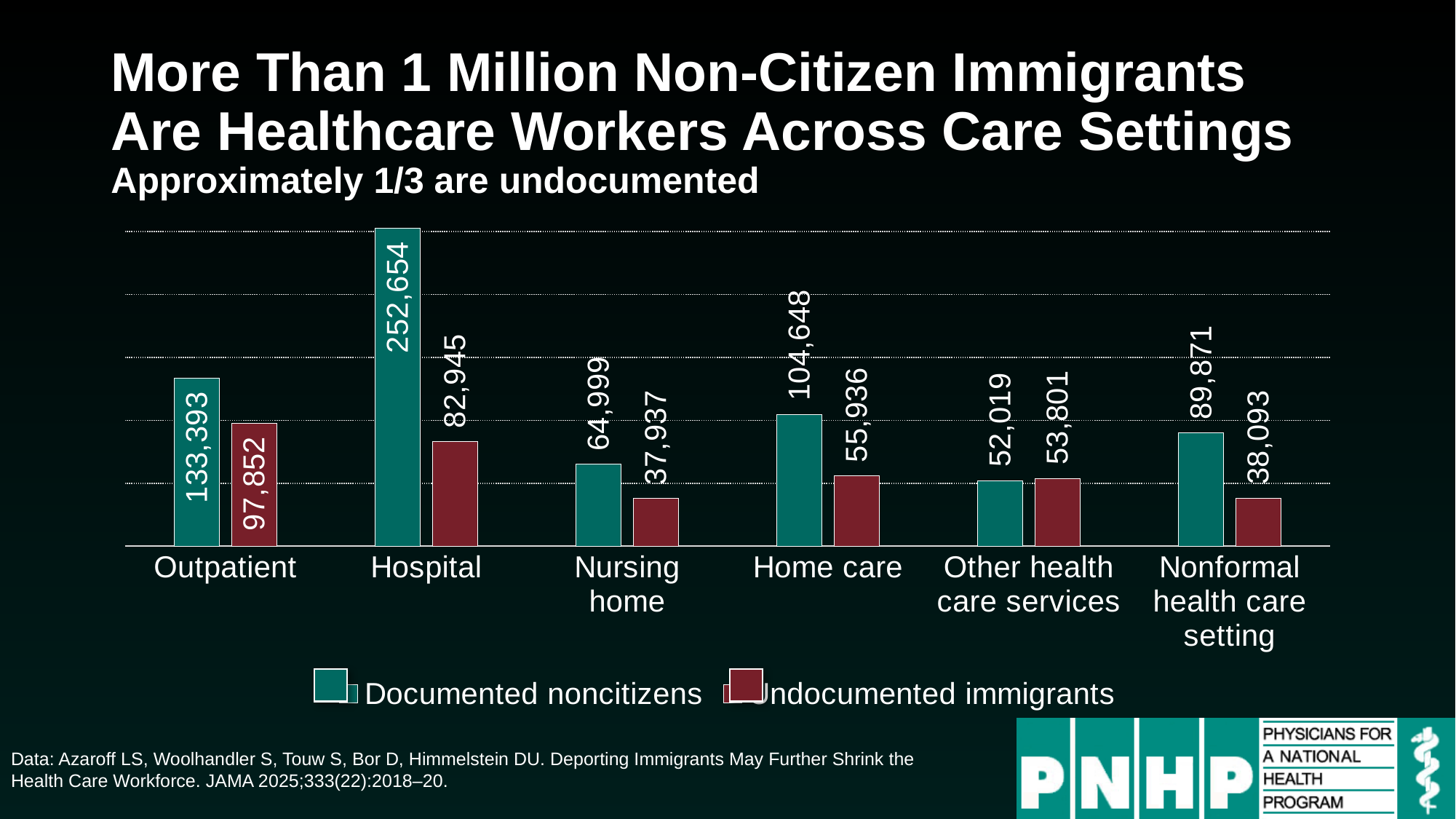
What is the value for Documented noncitizens in the Hospital category? 252,654 Which category has the lowest value for Undocumented immigrants? Nursing home How many categories are shown on the x axis? 6 What colour are the bars for Undocumented immigrants? Dark red Which category has the highest value for Documented noncitizens? Hospital What is the value for Undocumented immigrants in the Nursing home category? 37,937 Which is larger in the Other health care services category: Documented noncitizens or Undocumented immigrants? Undocumented immigrants What is the difference between Documented noncitizens and Undocumented immigrants in the Home care category? 48,712 What kind of chart is shown on the slide? Bar chart What is the value for Documented noncitizens in the Nonformal health care setting category? 89,871 How many series does the legend list? 2 What is the value for Undocumented immigrants in the Outpatient category? 97,852